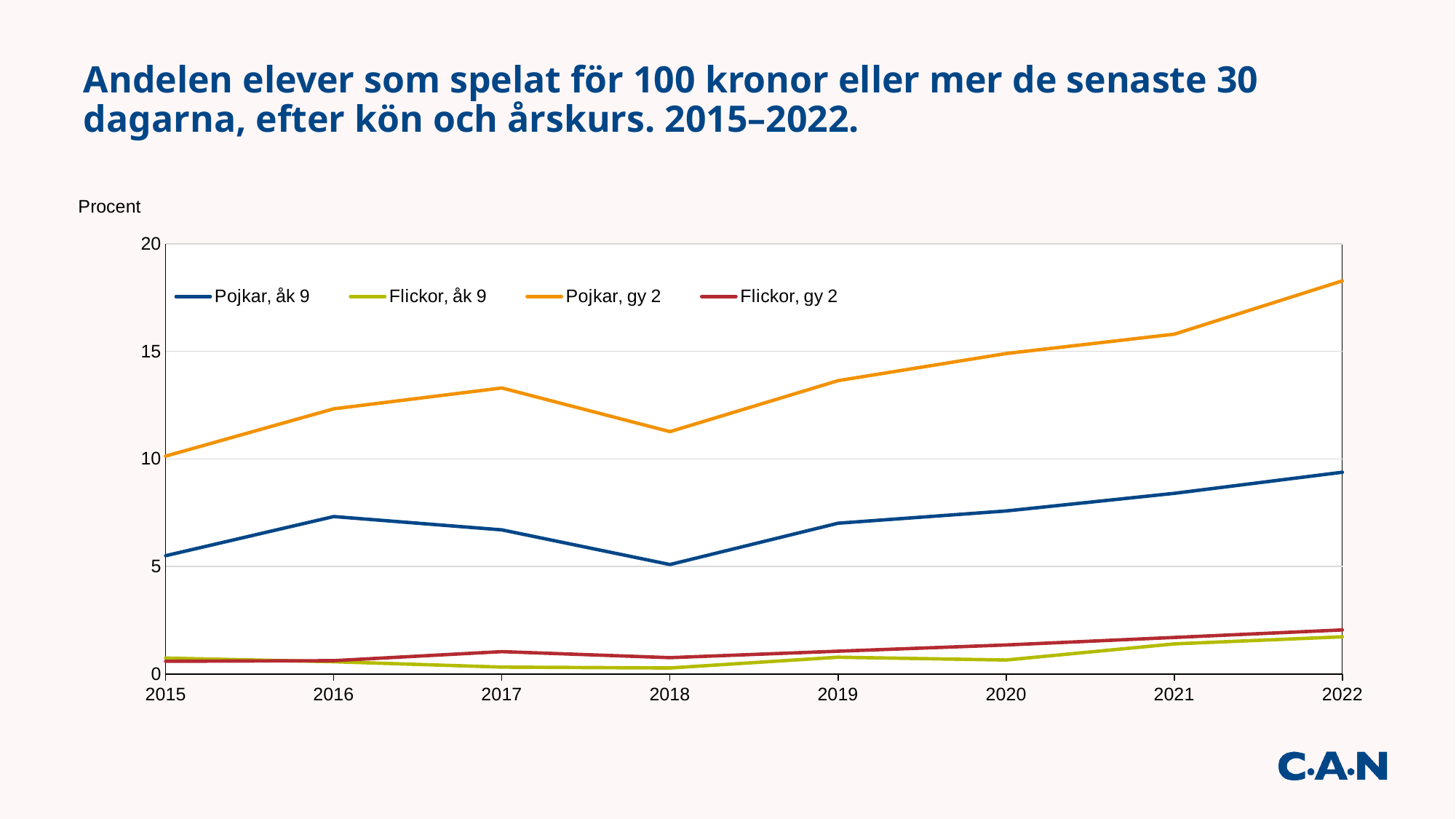
What type of chart is shown on the slide? line chart Which series has the highest value in 2022? Pojkar, gy 2 Is the value for Pojkar, åk 9 in 2022 greater or less than 10? less For Pojkar, gy 2, which year has the larger value, 2017 or 2018? 2017 Is the value for Pojkar, gy 2 in 2018 greater or less than 10? greater What is the label on the y axis? Procent Which series has the lowest value in 2018? Flickor, åk 9 How many years are shown along the x axis? 8 Does the Pojkar, gy 2 line rise or fall from 2018 to 2022? rise How many series does the legend list? 4 Is the value for Pojkar, gy 2 in 2022 greater or less than 15? greater In 2017, which is larger, Flickor, gy 2 or Flickor, åk 9? Flickor, gy 2